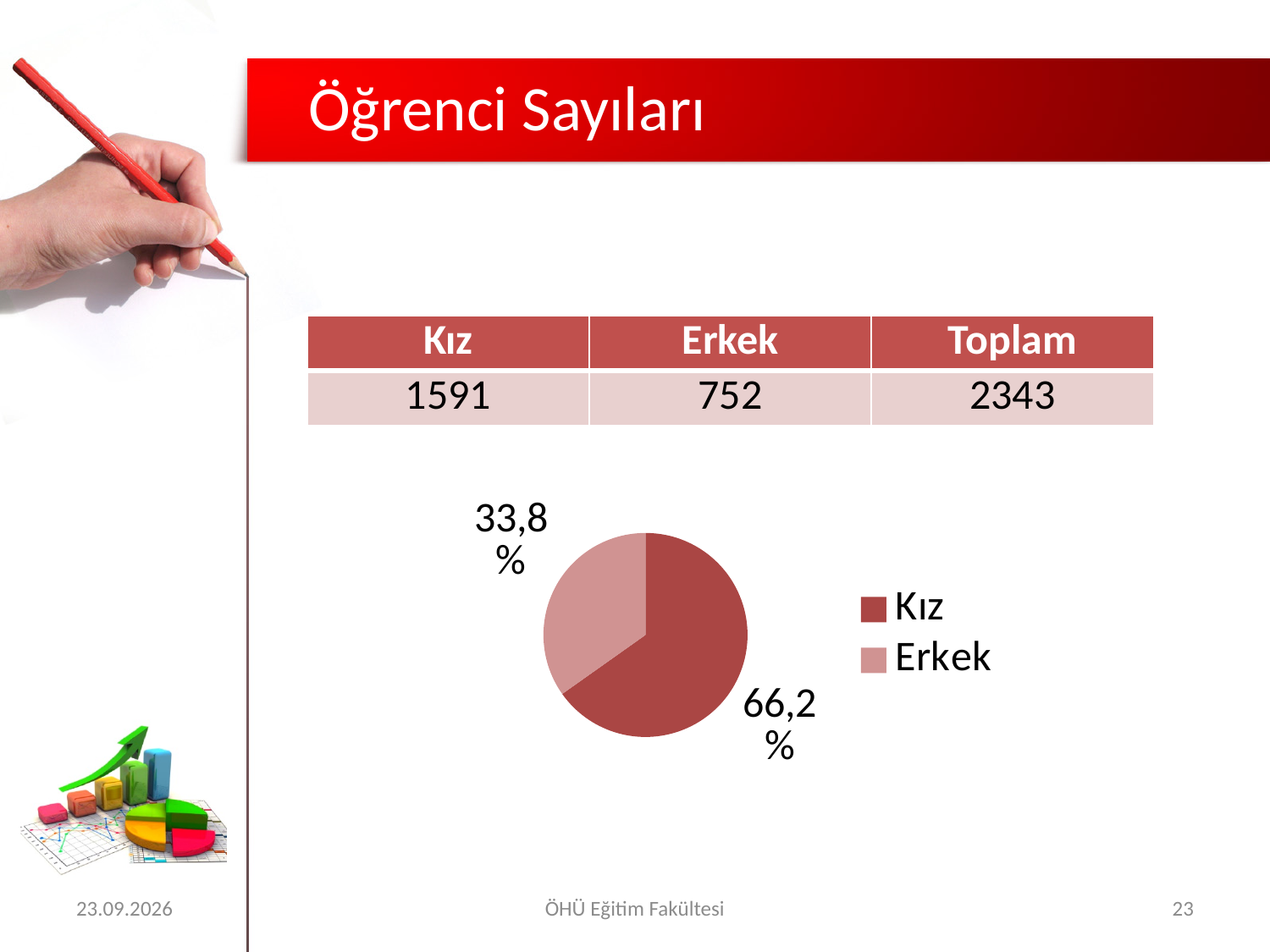
What share of the pie chart does the Erkek slice represent? 33,8% How many slices does the pie chart have? 2 Is the Kız slice of the pie chart greater or less than 50%? greater Which category has the smallest slice in the pie chart? Erkek What are the two legend entries of the pie chart? Kız and Erkek What kind of chart is shown on the slide? Pie chart What share of the pie chart does the Kız slice represent? 66,2% Which slice is larger in the pie chart, Kız or Erkek? Kız How many entries does the legend of the pie chart list? 2 What is the difference in percentage points between the Kız and Erkek slices? 32,4 Which legend entry is shown in the darker red colour in the pie chart? Kız Which category has the largest slice in the pie chart? Kız